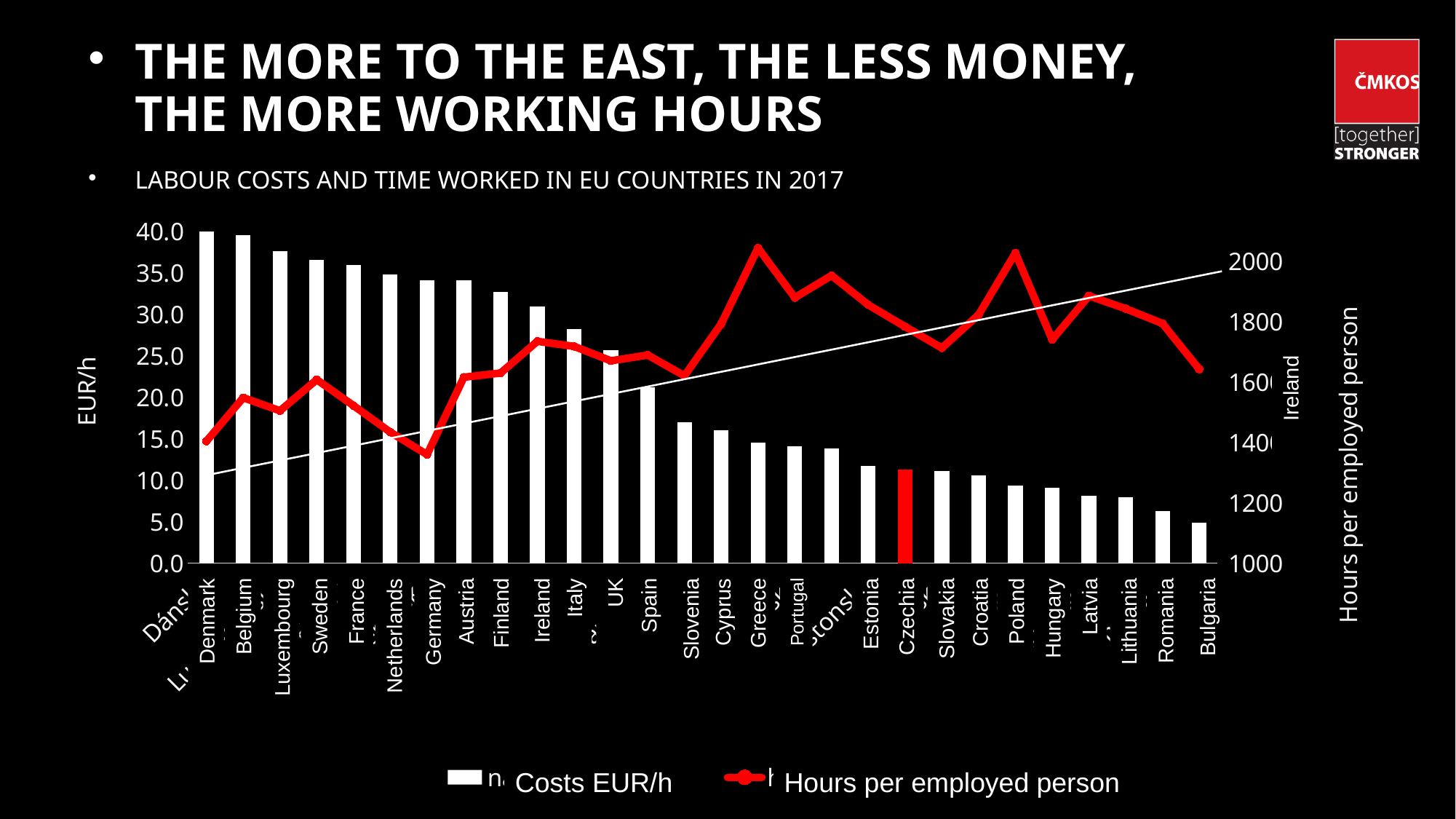
Which country has the lowest labour cost (Costs EUR/h) in the chart? Bulgaria Is the Costs EUR/h value for Czechia greater or less than 10.0? greater Is the Hours per employed person value for Greece greater or less than 2000? greater Do the Costs EUR/h bars generally rise or fall from left to right across the countries? fall Is the Hours per employed person value for Germany greater or less than 1400? less Which country has a higher Costs EUR/h value, Germany or Spain? Germany Which country has the highest labour cost (Costs EUR/h) in the chart? Denmark Which country's bar is highlighted in red? Czechia How many series does the legend list? 2